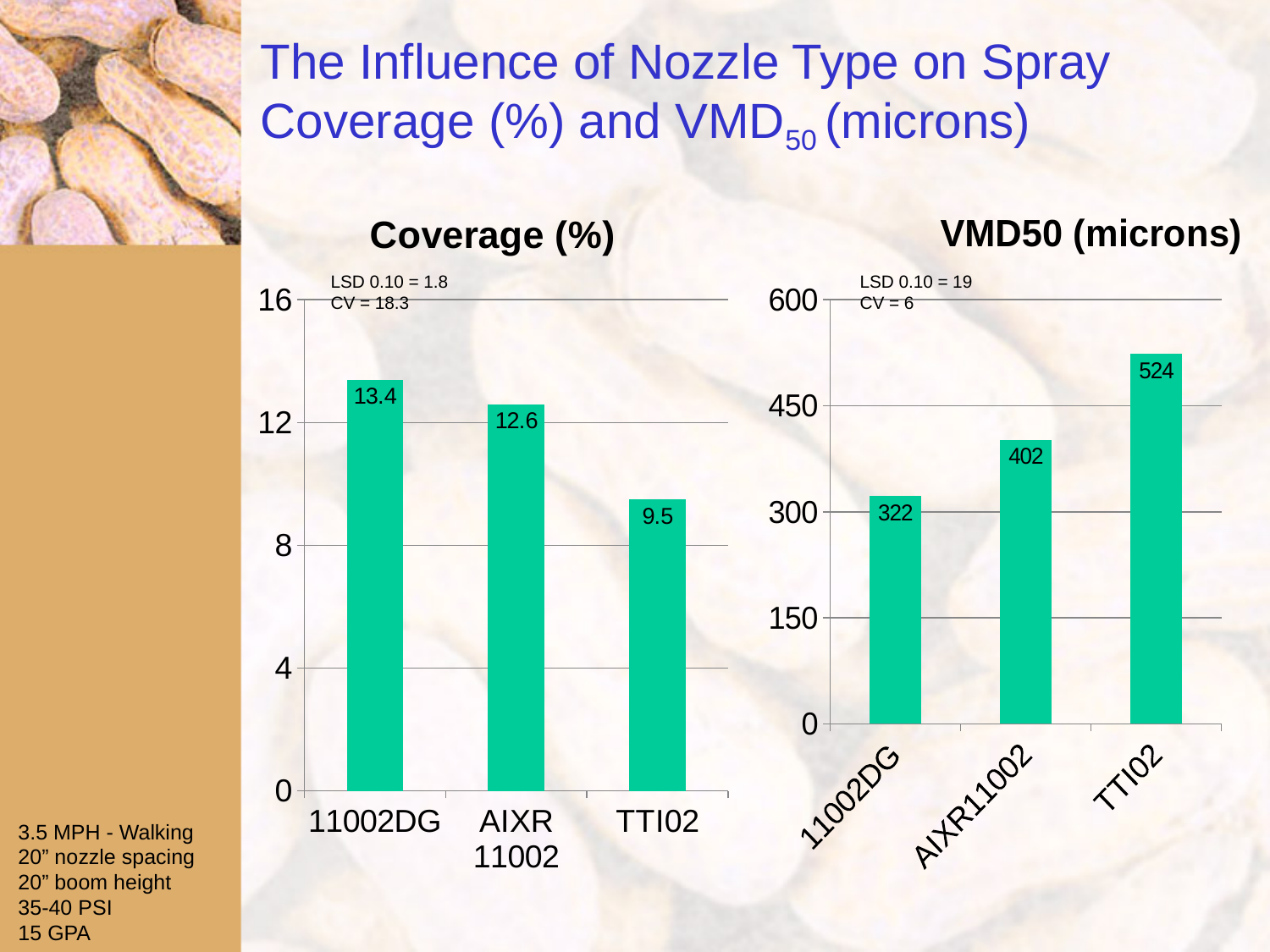
In the VMD50 (microns) chart, what is the difference between the values for TTI02 and 11002DG? 202 In the VMD50 (microns) chart, which is larger, the value for AIXR11002 or the value for 11002DG? AIXR11002 In the Coverage (%) chart, is the value for TTI02 greater or less than 12? less In the Coverage (%) chart, what is the value for TTI02? 9.5 In the VMD50 (microns) chart, which nozzle type has the lowest value? 11002DG In the VMD50 (microns) chart, what is the value for AIXR11002? 402 In the Coverage (%) chart, what is the difference between the values for 11002DG and TTI02? 3.9 In the Coverage (%) chart, which nozzle type has the highest coverage? 11002DG What kind of chart is the Coverage (%) chart? bar chart In the Coverage (%) chart, what is the value for 11002DG? 13.4 How many nozzle types are shown in the VMD50 (microns) chart? 3 In the VMD50 (microns) chart, what is the value for TTI02? 524